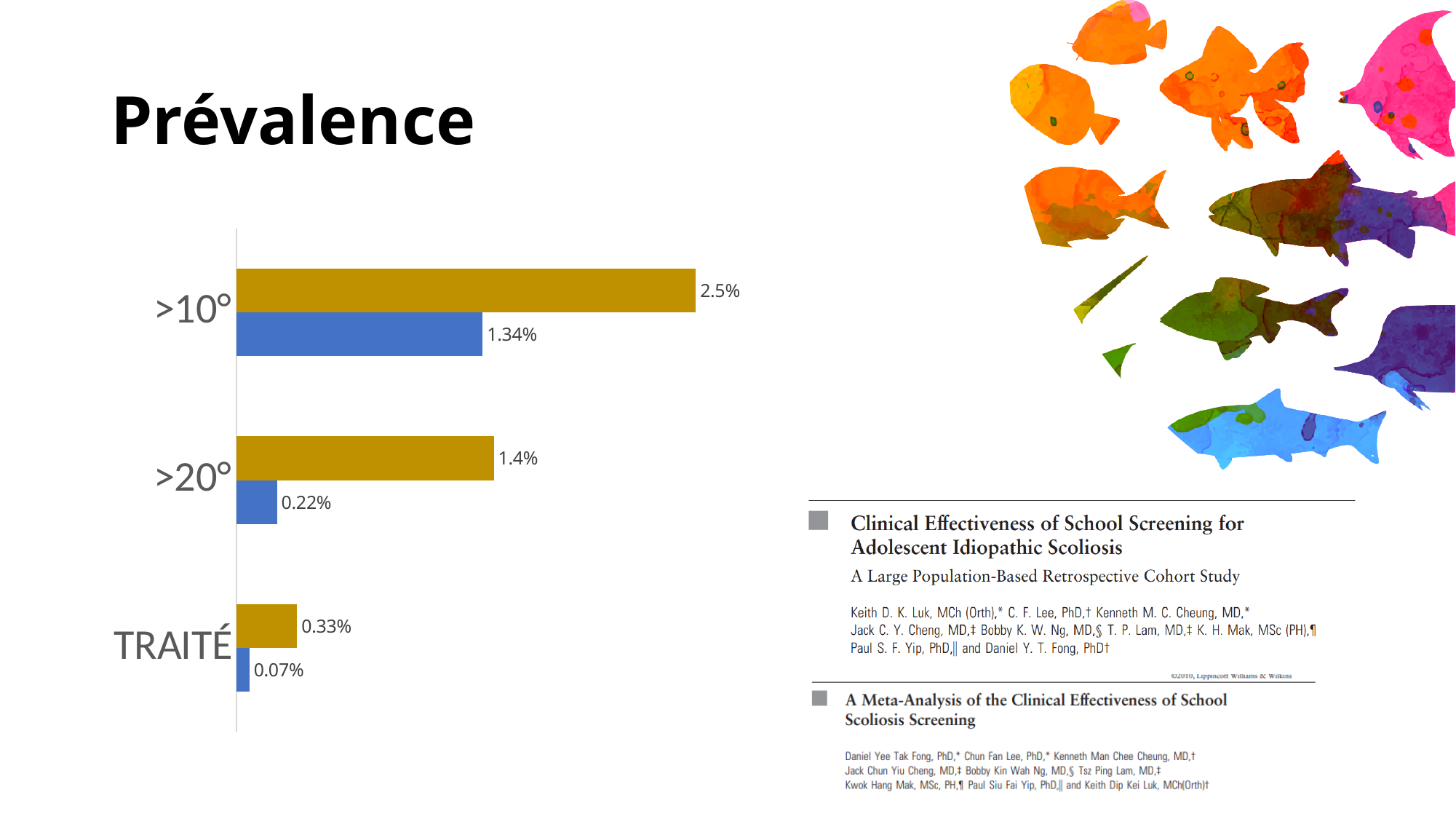
Which category has the lowest blue bar value? TRAITÉ What is the value of the gold bar for the >20° category? 1.4% What is the value of the gold bar for the TRAITÉ category? 0.33% What is the difference between the gold and blue bar values for the >10° category? 1.16% What is the value of the blue bar for the >10° category? 1.34% What is the value of the gold bar for the >10° category? 2.5% What is the value of the blue bar for the TRAITÉ category? 0.07% What kind of chart is shown on the slide? bar chart Which is larger: the gold bar for >20° or the blue bar for >10°? gold bar for >20° Which category has the highest gold bar value? >10° What is the value of the blue bar for the >20° category? 0.22% How many categories are shown on the chart? 3